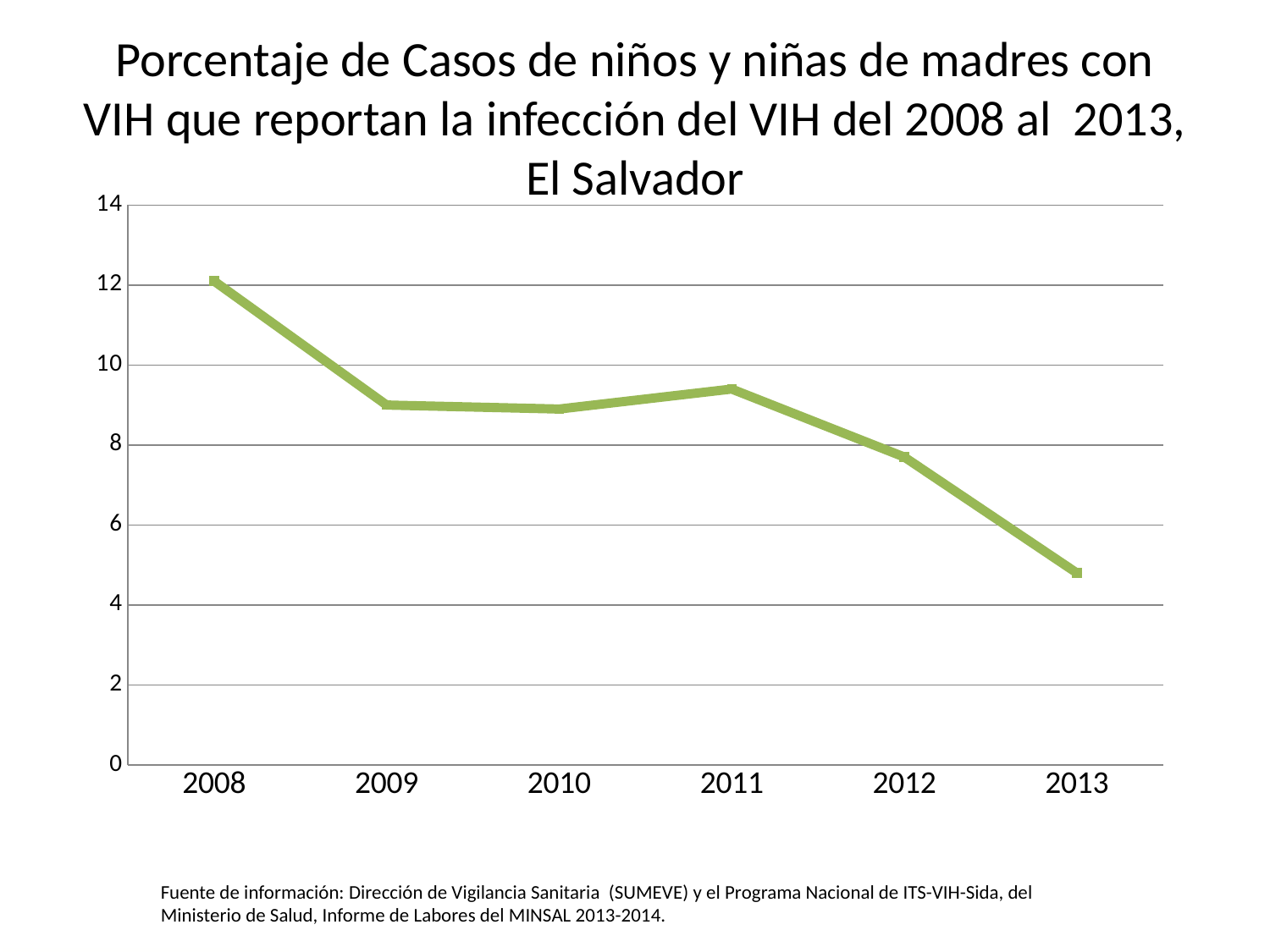
Is the value for 2012 greater or less than 8? less What kind of chart is shown on the slide? line chart What is the highest value shown on the y axis? 14 Which year has the lowest value? 2013 How many years are plotted on the x axis? 6 Which year has the highest value? 2008 Which year has the larger value, 2011 or 2012? 2011 Overall, do the values rise or fall from 2008 to 2013? fall Which year has the larger value, 2008 or 2013? 2008 Is the value for 2011 greater or less than 8? greater Is the value for 2013 greater or less than 6? less